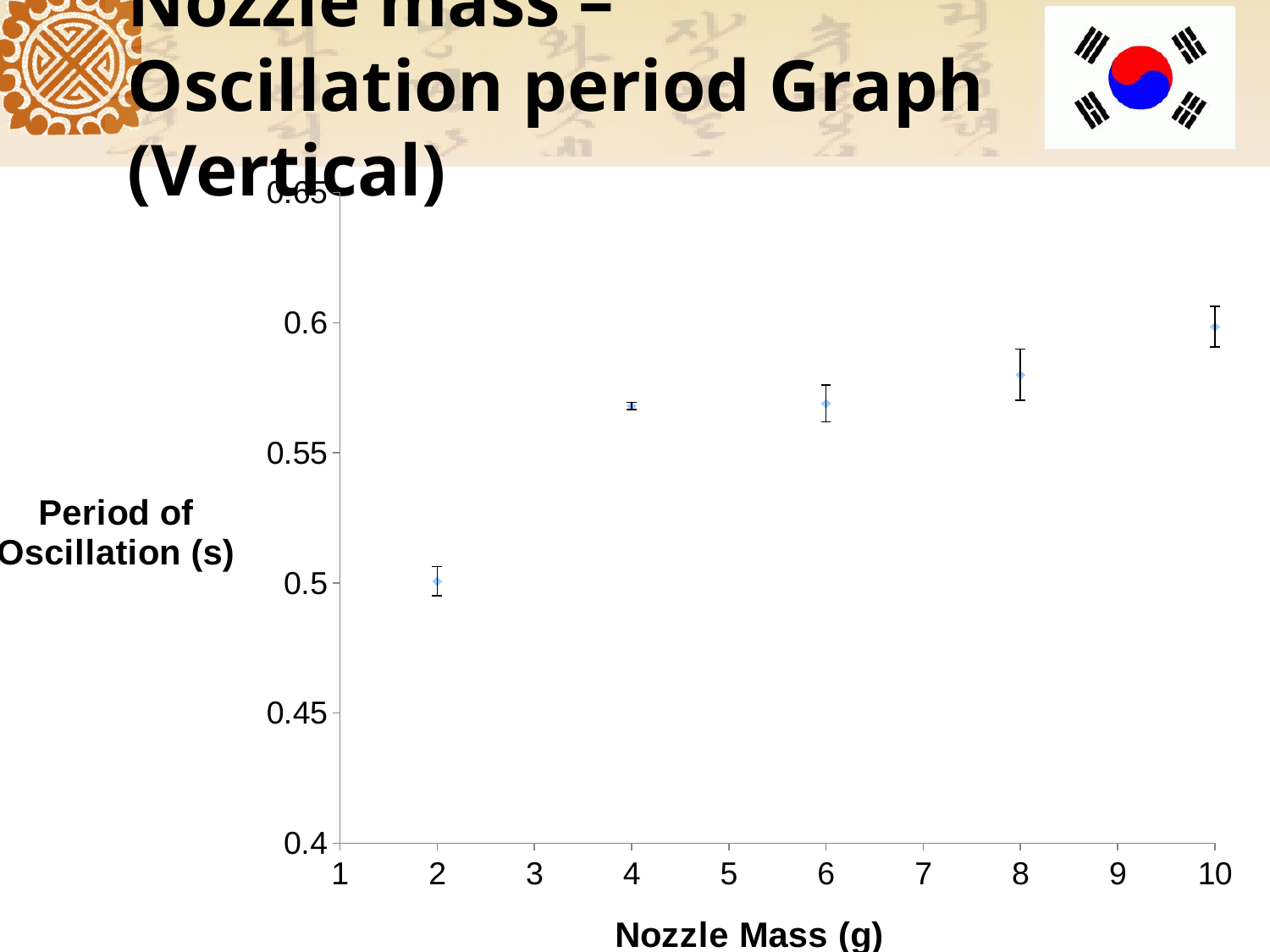
At which nozzle mass is the period of oscillation lowest? 2 At which nozzle mass is the period of oscillation highest? 10 How many data points are plotted on the chart? 5 Is the period of oscillation for a nozzle mass of 10 g greater or less than 0.55? greater What is the label of the y axis? Period of Oscillation (s) Which has a larger period of oscillation: a nozzle mass of 2 g or 10 g? 10 g Is the period of oscillation for a nozzle mass of 4 g greater or less than 0.55? greater Is the period of oscillation for a nozzle mass of 2 g greater or less than 0.55? less Does the period of oscillation rise or fall as nozzle mass increases along the x axis? rise What is the label of the x axis? Nozzle Mass (g) What kind of chart is shown on the slide? scatter plot